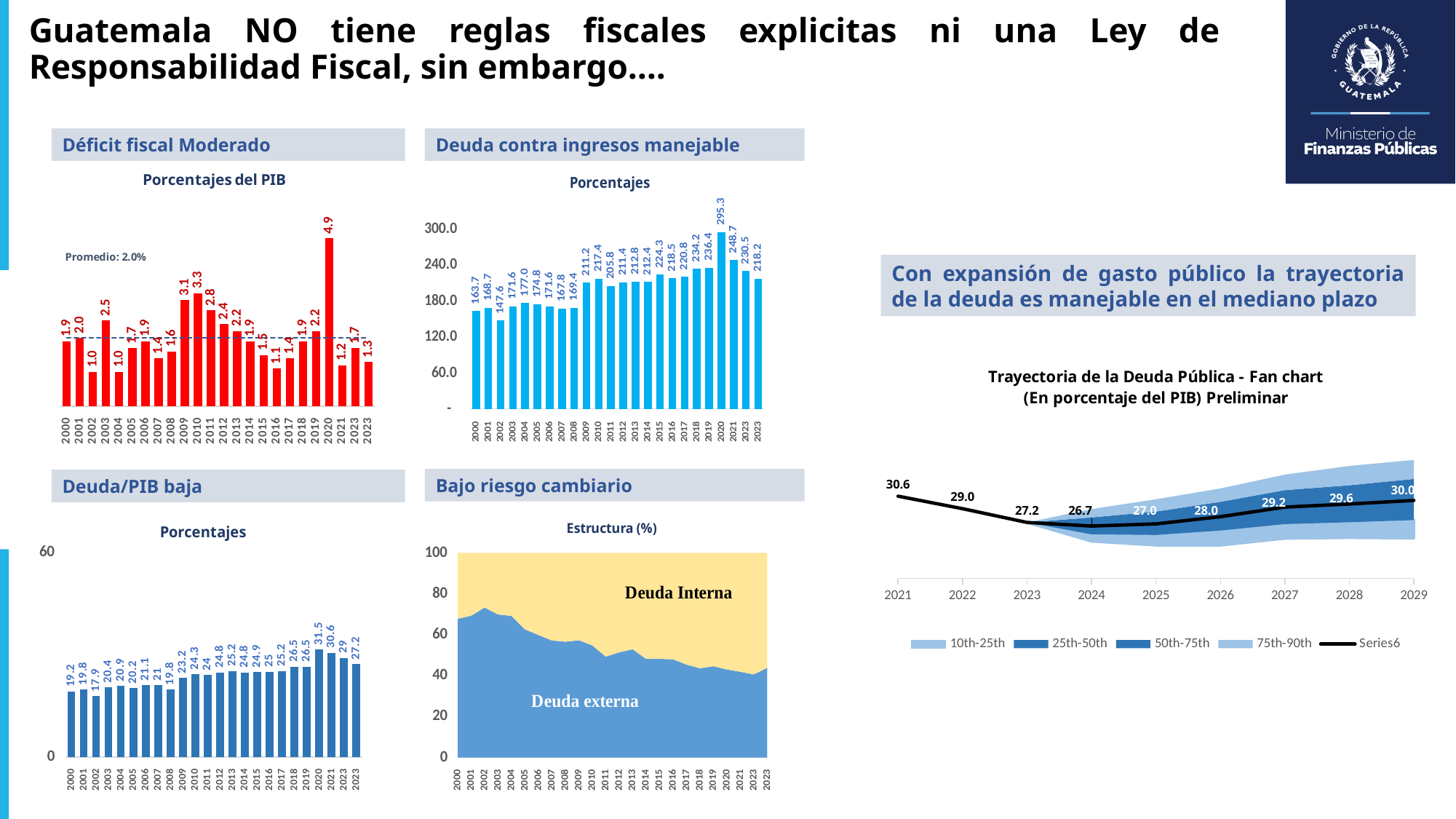
In the 'Deuda/PIB baja' chart, what is the value for 2023? 27.2 In the 'Deuda contra ingresos manejable' chart, what is the difference between the values for 2020 and 2021? 46.6 In the 'Trayectoria de la Deuda Pública - Fan chart', what is the value for 2024? 26.7 In the 'Déficit fiscal Moderado' chart, what average (Promedio) is shown? 2.0% In the 'Deuda contra ingresos manejable' chart, which year has the lowest value? 2002 How many entries does the legend of the 'Trayectoria de la Deuda Pública - Fan chart' list? 5 In the 'Deuda contra ingresos manejable' chart, what is the value for 2020? 295.3 In the 'Déficit fiscal Moderado' chart, which year has the highest value? 2020 In the 'Deuda/PIB baja' chart, what is the lowest value shown? 17.9 In the 'Deuda/PIB baja' chart, which is larger, the value for 2020 or the value for 2021? 2020 In the 'Bajo riesgo cambiario' chart, is the value for Deuda externa in 2023 greater or less than 60? less In the 'Déficit fiscal Moderado' chart, what is the value for 2010? 3.3